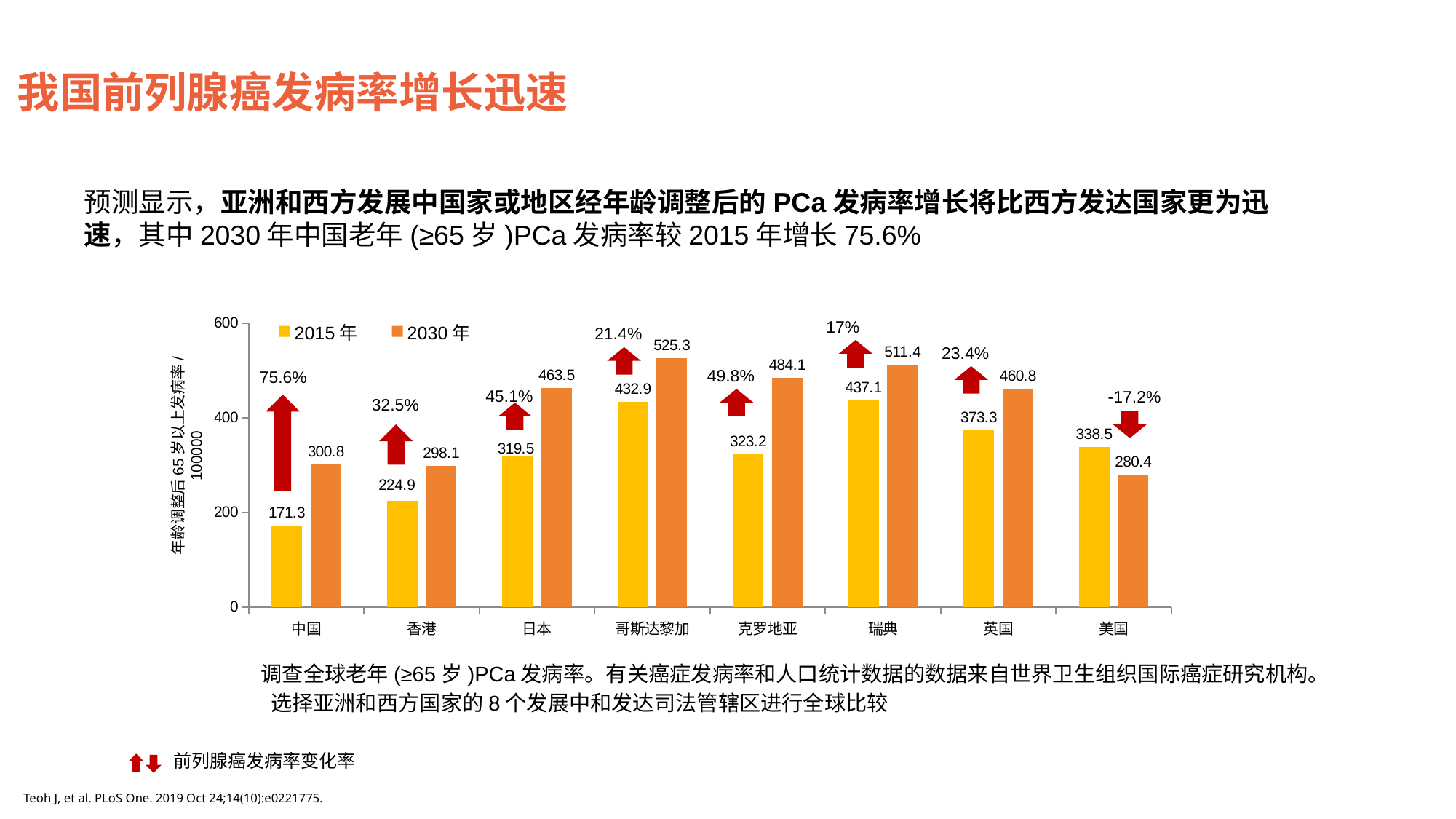
What is the 2030 年 value for 日本? 463.5 For 美国, which is larger, the 2015 年 value or the 2030 年 value? 2015 年 How many countries or regions are shown on the x axis? 8 What kind of chart is shown on the slide? bar chart What is the difference between the 2030 年 and 2015 年 values for 中国? 129.5 Which country has the lowest 2030 年 value? 美国 How many series does the legend list? 2 Which country has the highest 2030 年 value? 哥斯达黎加 What percentage change is shown above the bars for 克罗地亚? 49.8% Is the 2015 年 value for 香港 greater or less than 200? greater Which country has the lowest 2015 年 value? 中国 What is the 2015 年 value for 中国? 171.3